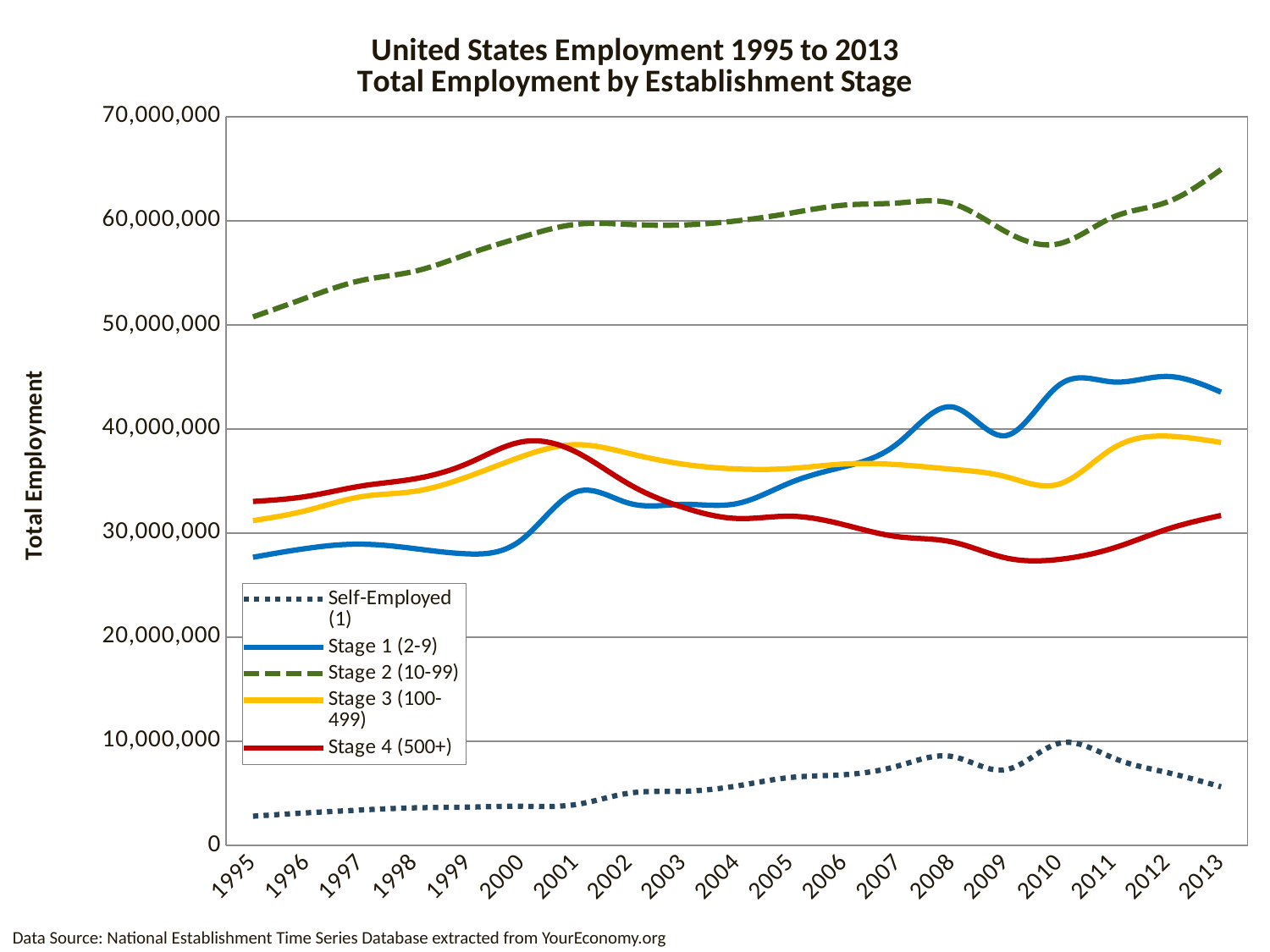
Does the Stage 4 (500+) line rise or fall between 2001 and 2010? Fall How many series does the legend list? 5 In 2013, which is larger: Stage 1 (2-9) or Stage 4 (500+)? Stage 1 (2-9) What kind of chart is shown on the slide? Line chart Which series has the lowest total employment across the whole period? Self-Employed (1) What is the title of the chart? United States Employment 1995 to 2013 Total Employment by Establishment Stage How many years are plotted along the x axis? 19 In 1995, which is larger: Stage 1 (2-9) or Stage 4 (500+)? Stage 4 (500+) Which series has the highest total employment across the whole period? Stage 2 (10-99) Is the value for Stage 1 (2-9) in 2012 greater or less than 40,000,000? greater Is the value for Stage 4 (500+) in 2010 greater or less than 30,000,000? less Is the value for Stage 2 (10-99) in 2013 greater or less than 60,000,000? greater